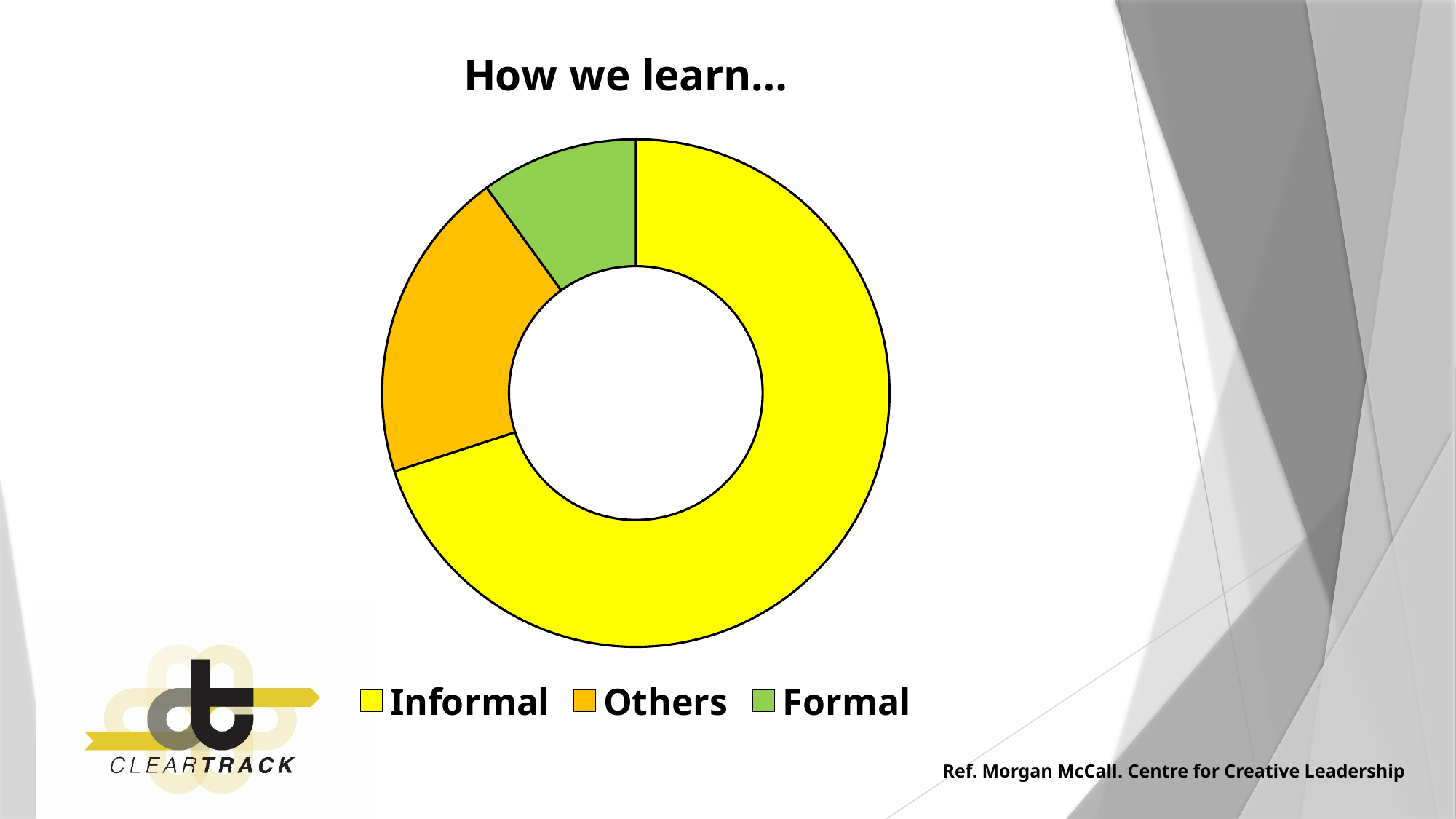
Which category has the largest share of the chart? Informal Which colour represents Formal in the chart? green Which is larger, the share for Others or the share for Formal? Others Which category has the smallest share of the chart? Formal How many categories does the chart show? 3 What is the title of the chart? How we learn… Does the Informal slice take up more or less than half of the chart? more How many entries does the legend list? 3 What kind of chart is shown on the slide? doughnut chart Which is larger, the share for Informal or the share for Others? Informal